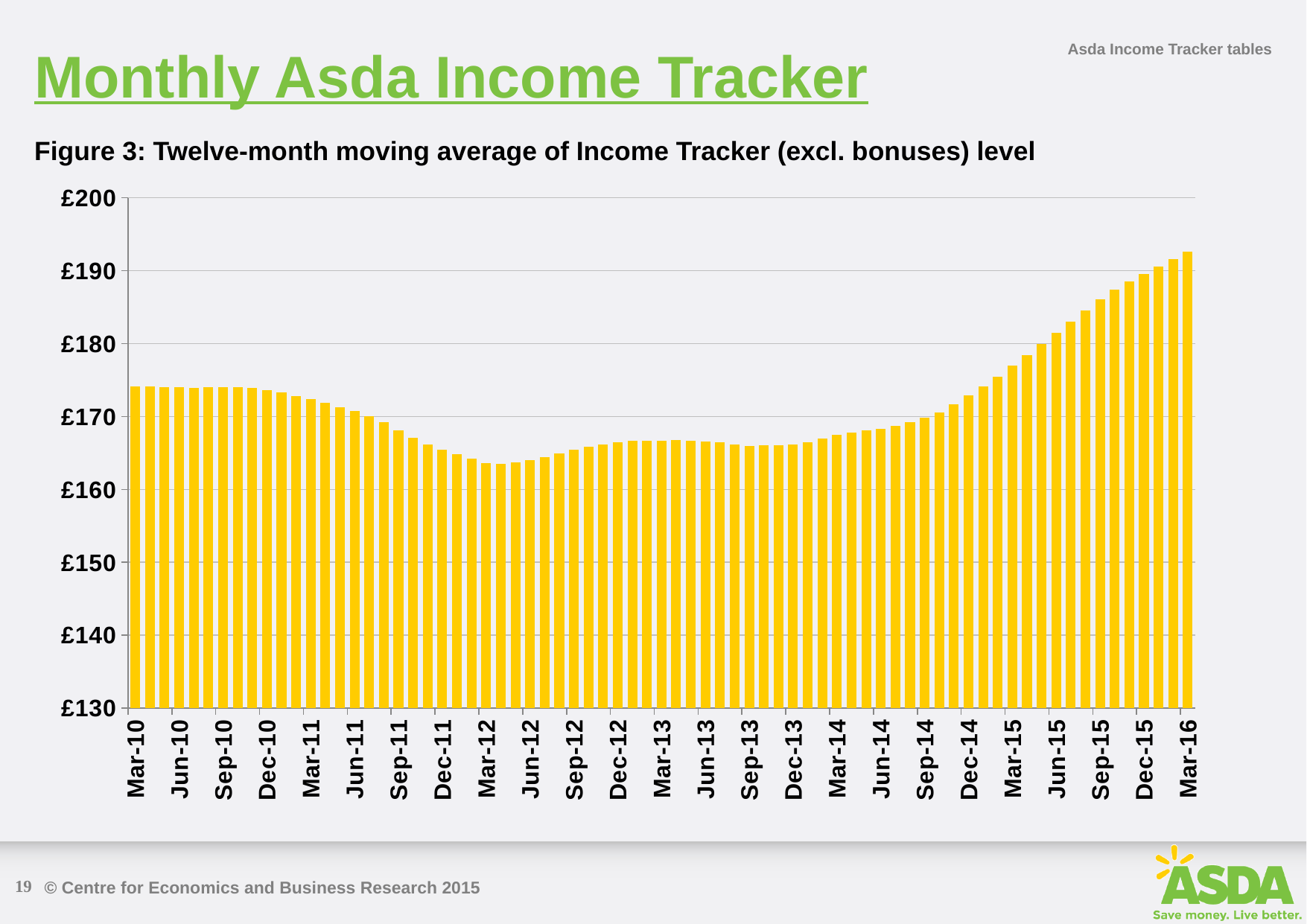
Do the values rise or fall between Sep-10 and Mar-12? fall What kind of chart is shown in Figure 3? Bar chart Which labelled month has the highest twelve-month moving average of the Income Tracker? Mar-16 Is the value for Sep-15 greater or less than £180? greater What is the title of the figure on the slide? Figure 3: Twelve-month moving average of Income Tracker (excl. bonuses) level Is the value for Mar-12 greater or less than £170? less Is the value for Mar-10 greater or less than £170? greater Which is larger, the value for Mar-10 or the value for Mar-12? Mar-10 Do the values rise or fall between Mar-14 and Mar-16? rise Which is larger, the value for Mar-16 or the value for Mar-10? Mar-16